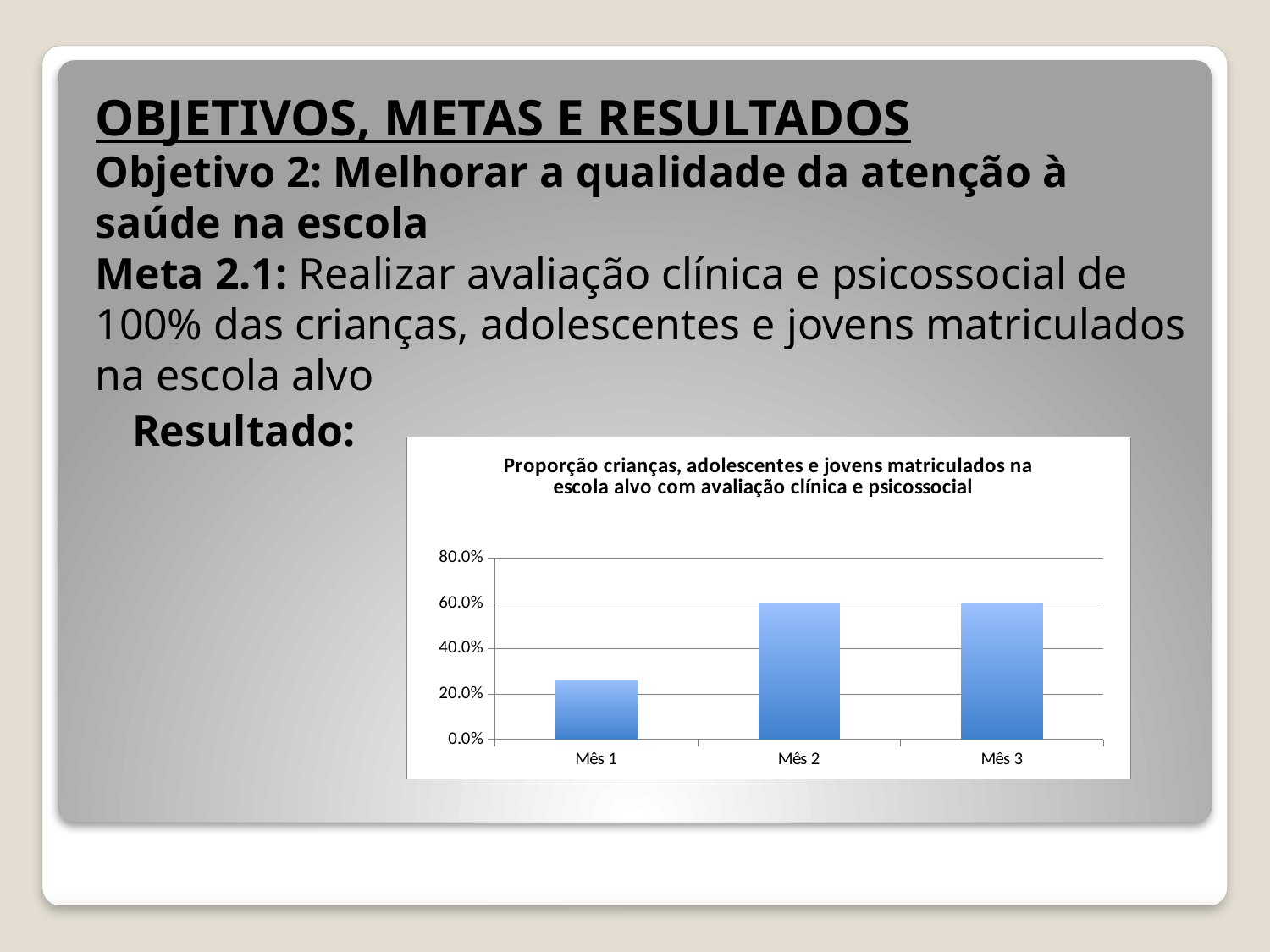
Is the value for Mês 2 greater or less than 40.0%? greater Which is larger, the value for Mês 1 or the value for Mês 3? Mês 3 Which month has the lowest proportion in the chart? Mês 1 Is the value for Mês 3 greater or less than 80.0%? less How many categories (months) are shown on the x axis of the chart? 3 What is the highest tick value shown on the y axis of the chart? 80.0% What is the title of the chart? Proporção crianças, adolescentes e jovens matriculados na escola alvo com avaliação clínica e psicossocial Do the values rise or fall from Mês 1 to Mês 2? rise Is the value for Mês 1 greater or less than 40.0%? less What kind of chart is shown on the slide? bar chart Which is larger, the value for Mês 1 or the value for Mês 2? Mês 2